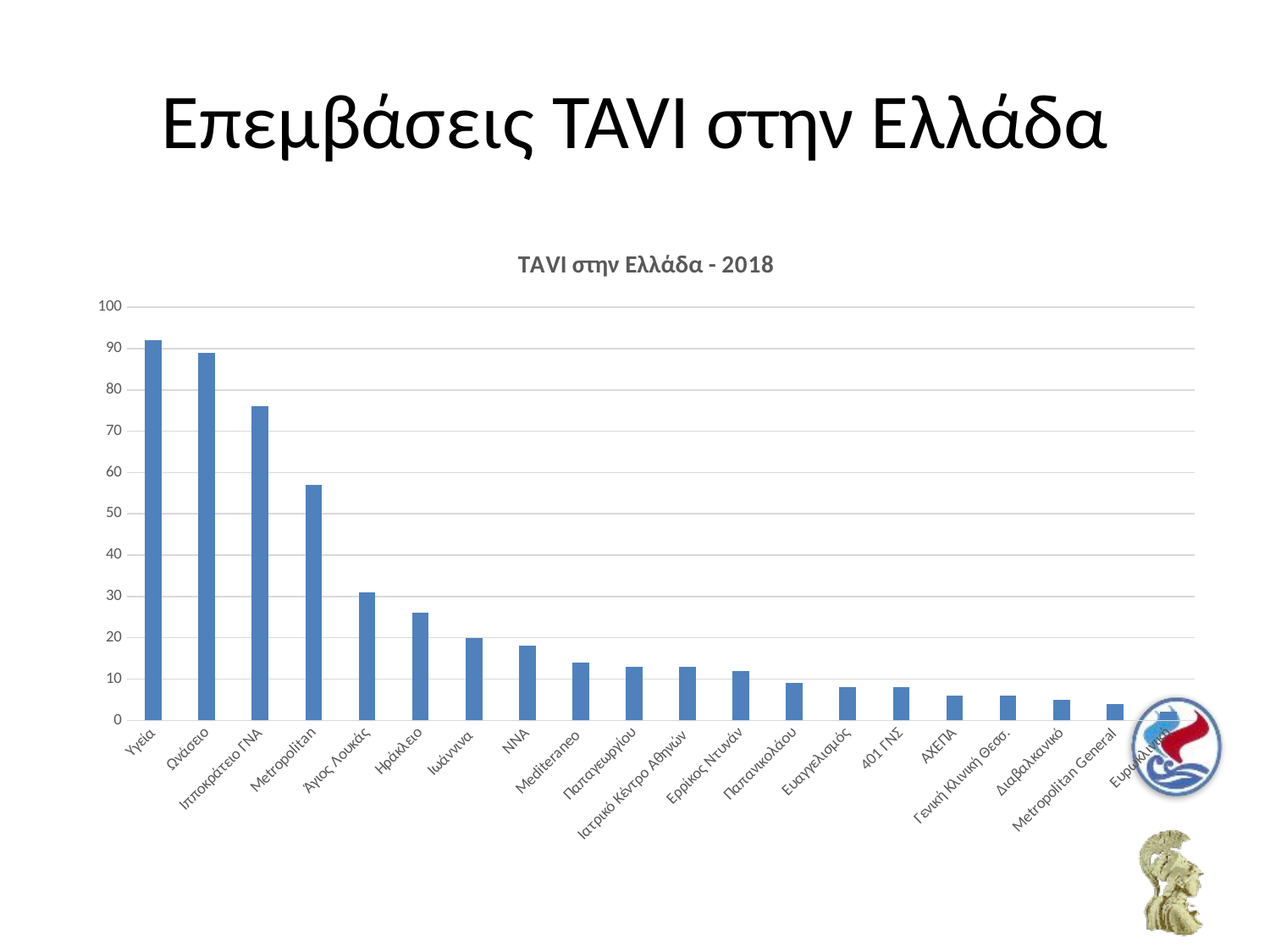
Is the value for Υγεία greater or less than 80? greater Is the value for Ηράκλειο greater or less than 20? greater What kind of chart is shown on the slide? bar chart Which has a higher value, Metropolitan or Άγιος Λουκάς? Metropolitan Which has a higher value, Ηράκλειο or ΝΝΑ? Ηράκλειο Is the value for Άγιος Λουκάς greater or less than 40? less Do the values rise or fall moving from left to right along the x axis? fall Which has a higher value, Ωνάσειο or Ιπποκράτειο ΓΝΑ? Ωνάσειο What is the title of the chart? TAVI στην Ελλάδα - 2018